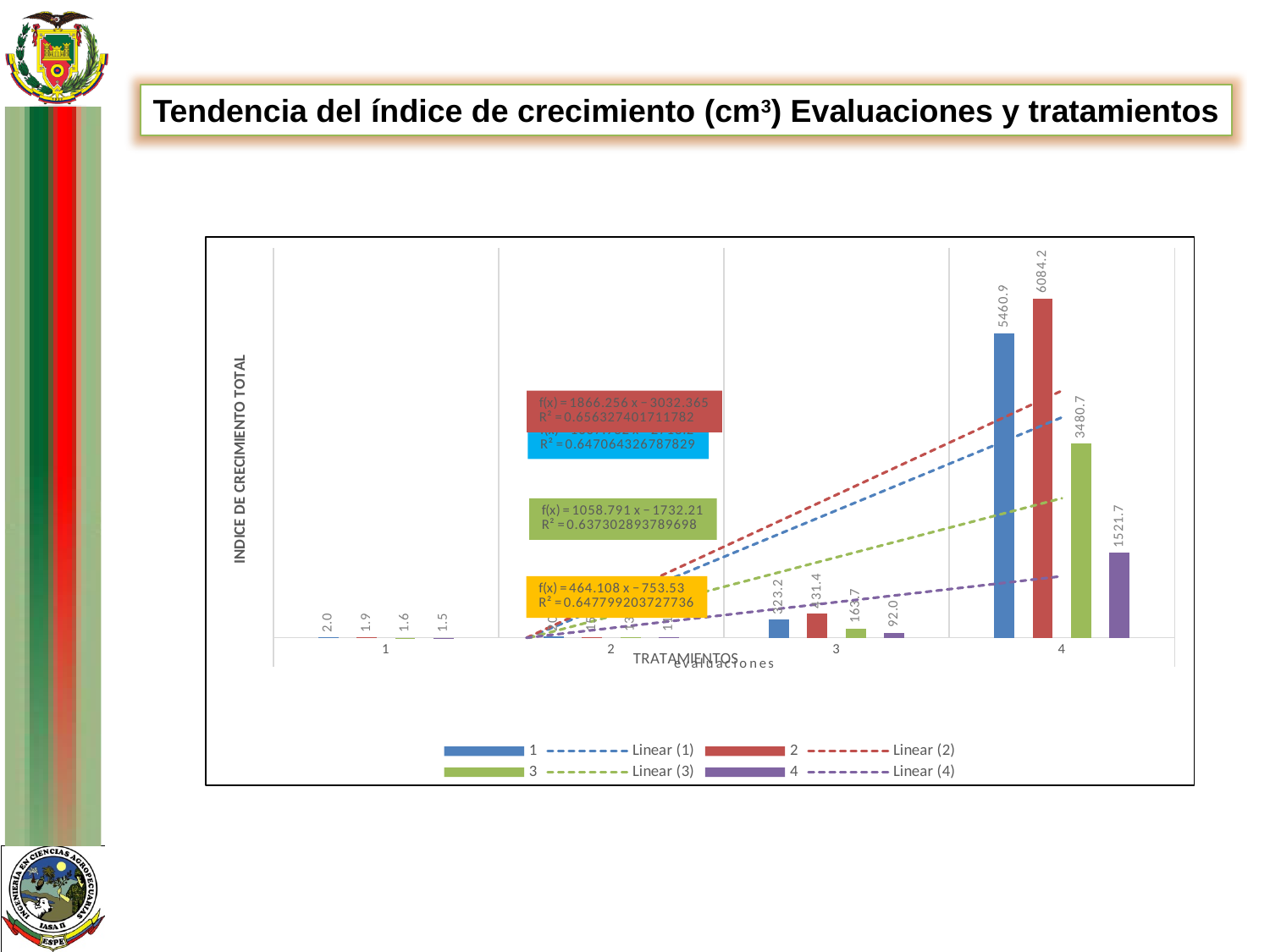
Do the values for series 2 rise or fall from evaluation 1 to evaluation 4? rise What is the value for series 1 at evaluation 4? 5460.9 What is the value for series 3 at evaluation 4? 3480.7 What is the value for series 2 at evaluation 4? 6084.2 Which series has the highest value at evaluation 4? 2 What is the value for series 4 at evaluation 4? 1521.7 What is the difference between the values of series 2 and series 1 at evaluation 4? 623.3 What is the value for series 1 at evaluation 1? 2.0 How many entries does the legend list? 8 Which series has the lowest value at evaluation 4? 4 What kind of chart is shown on the slide? bar chart What is the value for series 4 at evaluation 3? 92.0